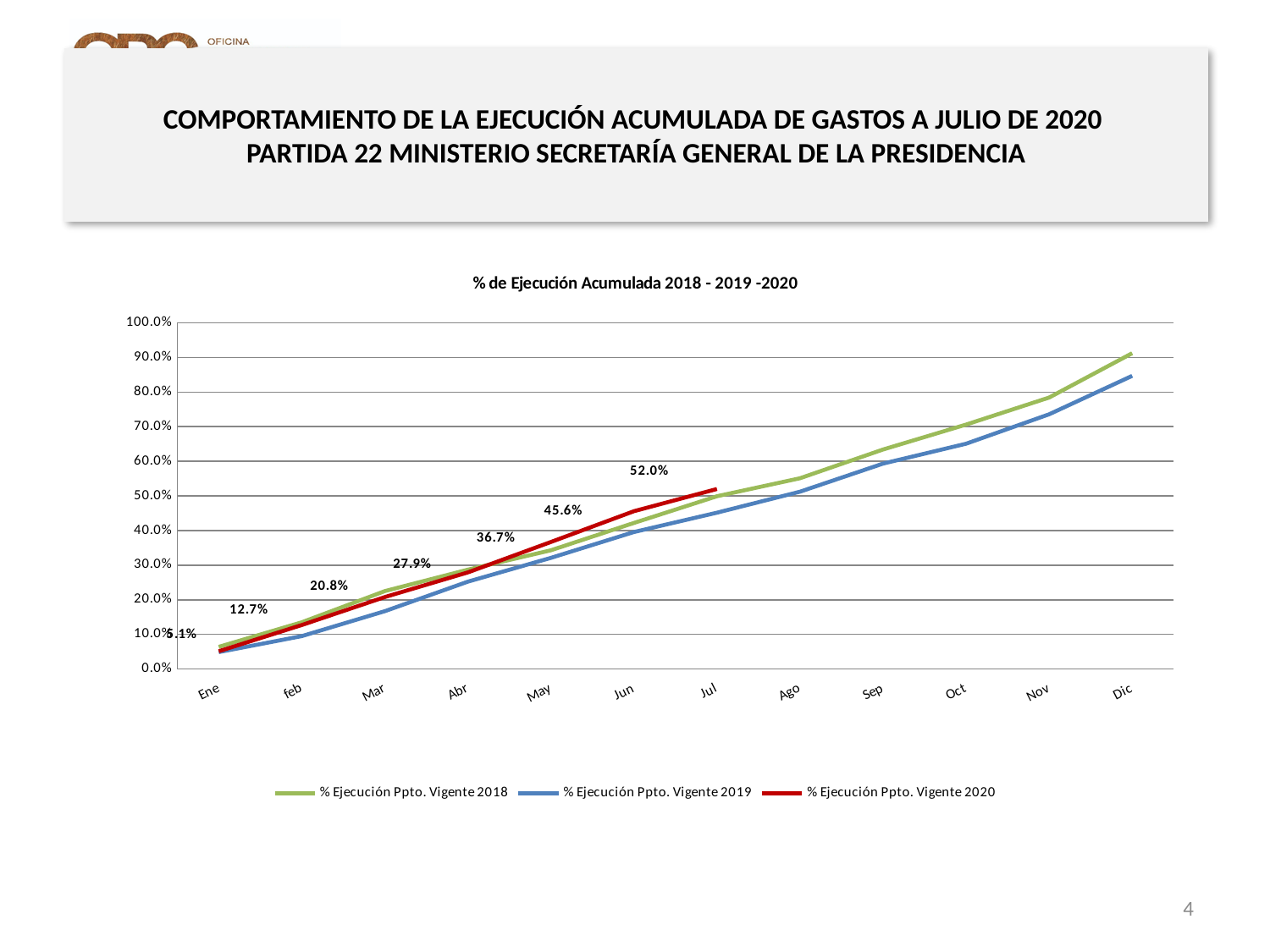
In Dic, which series is higher: % Ejecución Ppto. Vigente 2018 or % Ejecución Ppto. Vigente 2019? % Ejecución Ppto. Vigente 2018 What kind of chart is shown on the slide? Line chart How many months are shown on the x axis? 12 What is the value of % Ejecución Ppto. Vigente 2020 for Jul? 52.0% In which month does the % Ejecución Ppto. Vigente 2020 series reach its highest labelled value? Jul By how many percentage points did % Ejecución Ppto. Vigente 2020 increase from Jun to Jul? 6.4 How many series does the legend list? 3 Is the value for % Ejecución Ppto. Vigente 2019 in Dic greater or less than 80.0%? greater In which month is the % Ejecución Ppto. Vigente 2020 series lowest? Ene What is the value of % Ejecución Ppto. Vigente 2020 for Mar? 20.8% What is the value of % Ejecución Ppto. Vigente 2020 for Ene? 5.1% Do the values of the % Ejecución Ppto. Vigente 2018 series rise or fall from Ene to Dic? Rise